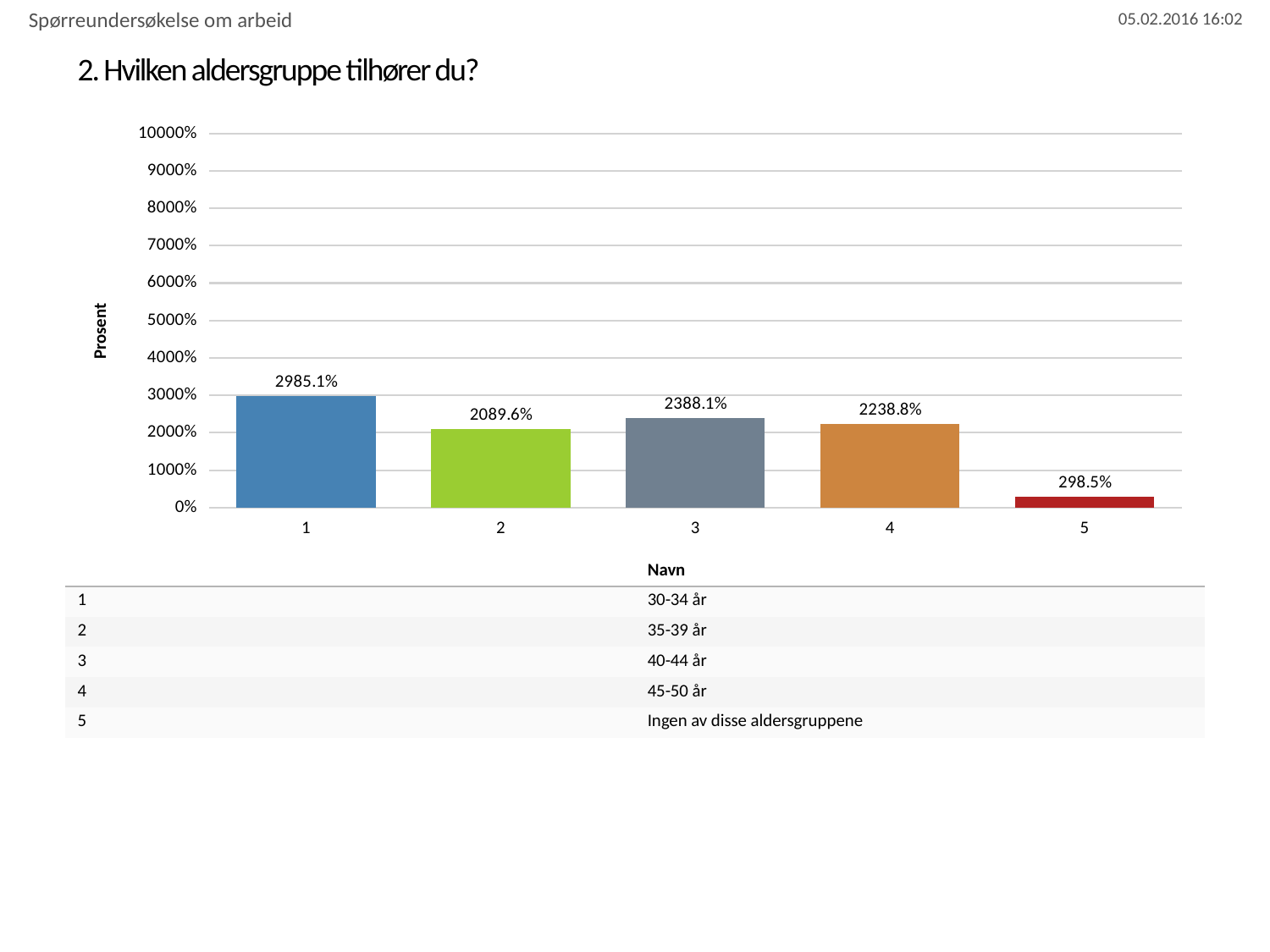
What is the difference between the values for category 3 and category 4? 149.3% What kind of chart is shown on the slide? bar chart Which category has the highest value? 1 What is the value shown for category 3? 2388.1% What is the difference between the values for category 1 and category 2? 895.5% What is the value shown for category 5? 298.5% What is the value shown for category 1? 2985.1% Which has a larger value, category 3 or category 4? 3 What is the value shown for category 2? 2089.6% How many categories are shown in the chart? 5 Which category has the lowest value? 5 What is the label of the y axis? Prosent